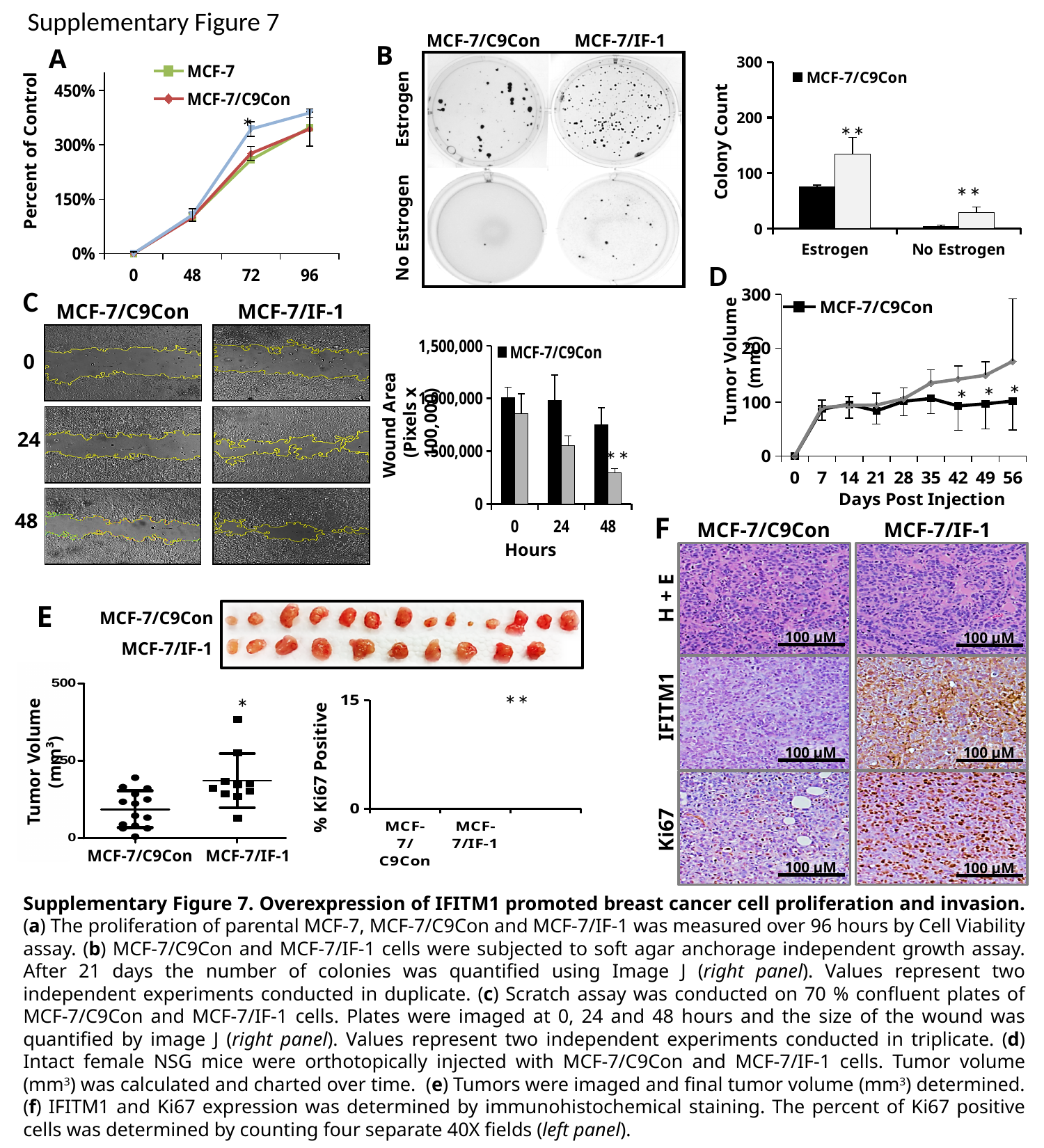
In the Colony Count chart (panel B), is the value for the black MCF-7/C9Con bar under Estrogen greater or less than 100? less In chart A (Percent of Control), how many time points are shown on the x axis? 4 In chart D (Tumor Volume vs Days Post Injection), is the grey line's value at day 56 greater or less than 100? greater In chart D (Tumor Volume vs Days Post Injection), how many days are labelled on the x axis? 9 In the Wound Area chart (panel C), how many time points (Hours) are shown on the x axis? 3 In the Colony Count chart (panel B), what kind of chart is shown? bar chart In chart A (Percent of Control), what kind of chart is shown? line chart In chart A (Percent of Control), do the values rise or fall from 0 to 96 hours? rise In the Wound Area chart (panel C), is the grey bar at 48 hours greater or less than 500,000? less In the Wound Area chart (panel C), do the grey bars rise or fall from 0 to 48 hours? fall In the Colony Count chart (panel B), which category has the higher colony count for MCF-7/C9Con, Estrogen or No Estrogen? Estrogen